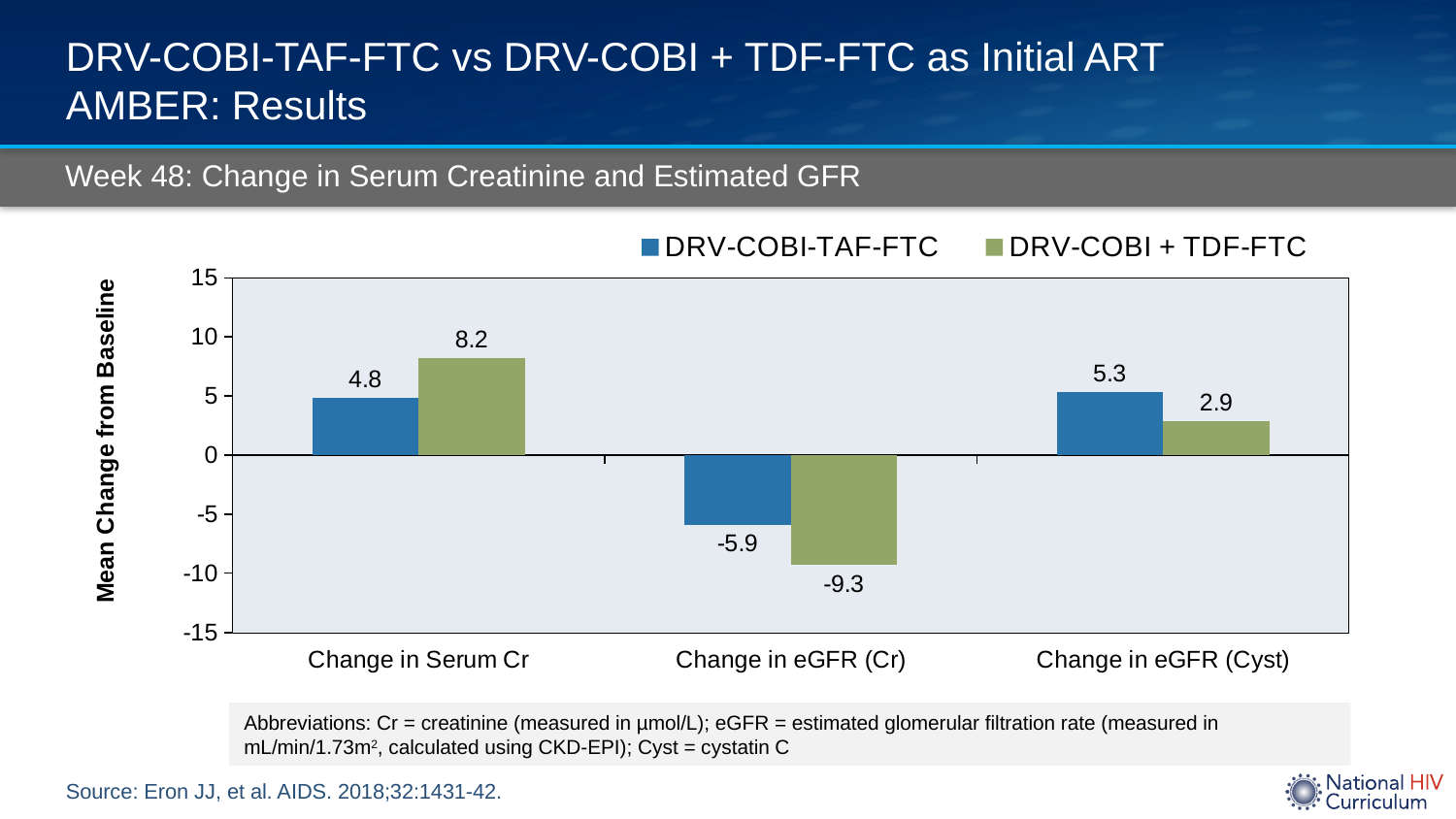
What is the value for DRV-COBI-TAF-FTC in the Change in Serum Cr category? 4.8 What kind of chart is shown on the slide? Bar chart How many categories are shown on the x axis? 3 In the Change in eGFR (Cyst) category, which series has the larger value? DRV-COBI-TAF-FTC Which category has the lowest value for DRV-COBI + TDF-FTC? Change in eGFR (Cr) What is the difference between the DRV-COBI + TDF-FTC and DRV-COBI-TAF-FTC values in the Change in Serum Cr category? 3.4 What is the value for DRV-COBI + TDF-FTC in the Change in eGFR (Cr) category? -9.3 What is the value for DRV-COBI-TAF-FTC in the Change in eGFR (Cyst) category? 5.3 How many series does the legend list? 2 Is the value for DRV-COBI + TDF-FTC in the Change in eGFR (Cr) category greater or less than -5? less Which category has the highest value for DRV-COBI-TAF-FTC? Change in eGFR (Cyst) What is the value for DRV-COBI + TDF-FTC in the Change in Serum Cr category? 8.2